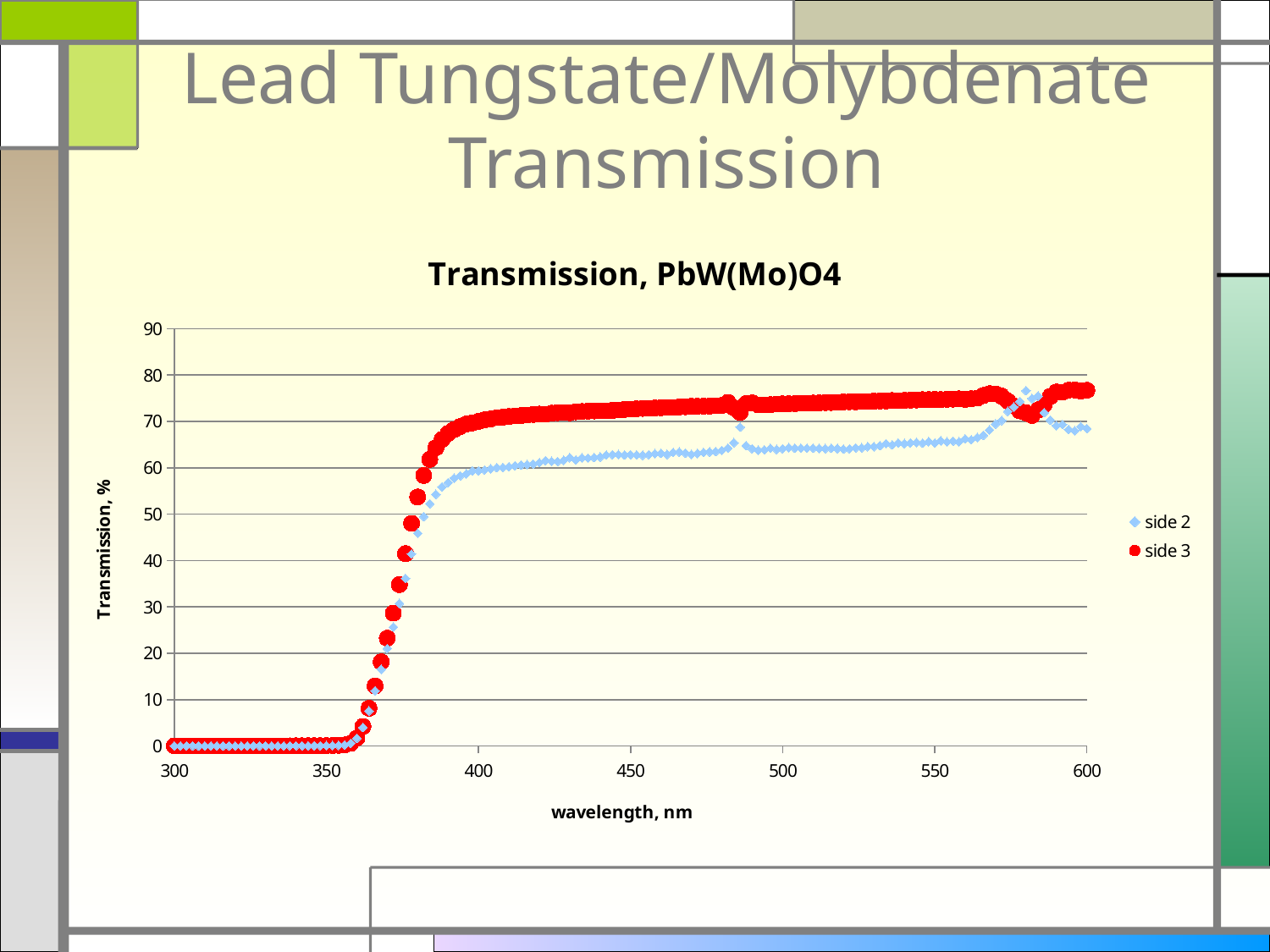
What is the title of the chart? Transmission, PbW(Mo)O4 At 600 nm, which series has the higher transmission, side 2 or side 3? side 3 Is the value for side 3 at 450 nm greater or less than 70? greater How many series does the legend list? 2 What is the transmission value for side 3 at 300 nm? 0 At 450 nm, which series has the higher transmission, side 2 or side 3? side 3 Is the value for side 3 at 350 nm greater or less than 10? less Do the transmission values generally rise or fall as wavelength increases from 300 nm to 600 nm? rise What are the two series named in the legend? side 2 and side 3 Is the value for side 2 at 450 nm greater or less than 70? less What kind of chart is shown on the slide? scatter chart